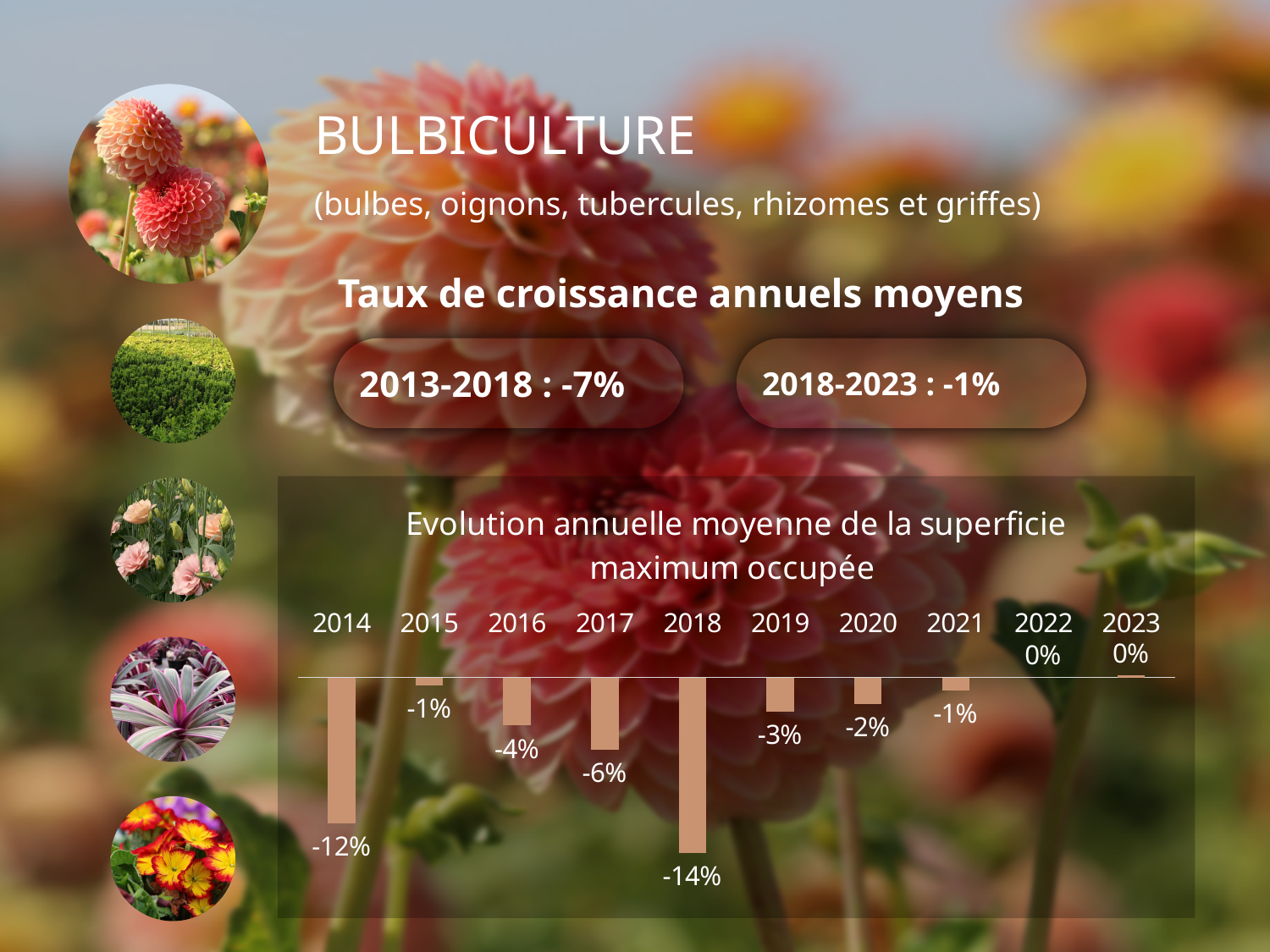
What is the value for 2019 in the chart? -3% What is the value for 2018 in the chart? -14% What is the title of the chart? Evolution annuelle moyenne de la superficie maximum occupée Which value is larger, 2016 or 2017? 2016 What is the value for 2022 in the chart? 0% What is the value for 2014 in the chart? -12% Which year has the lowest value in the chart? 2018 Which two years share the same value of -1%? 2015 and 2021 What kind of chart is shown on the slide? Bar chart Do the values generally rise or fall from 2018 to 2023? Rise What is the difference between the values for 2014 and 2018? 2 percentage points How many years are shown on the x axis of the chart? 10